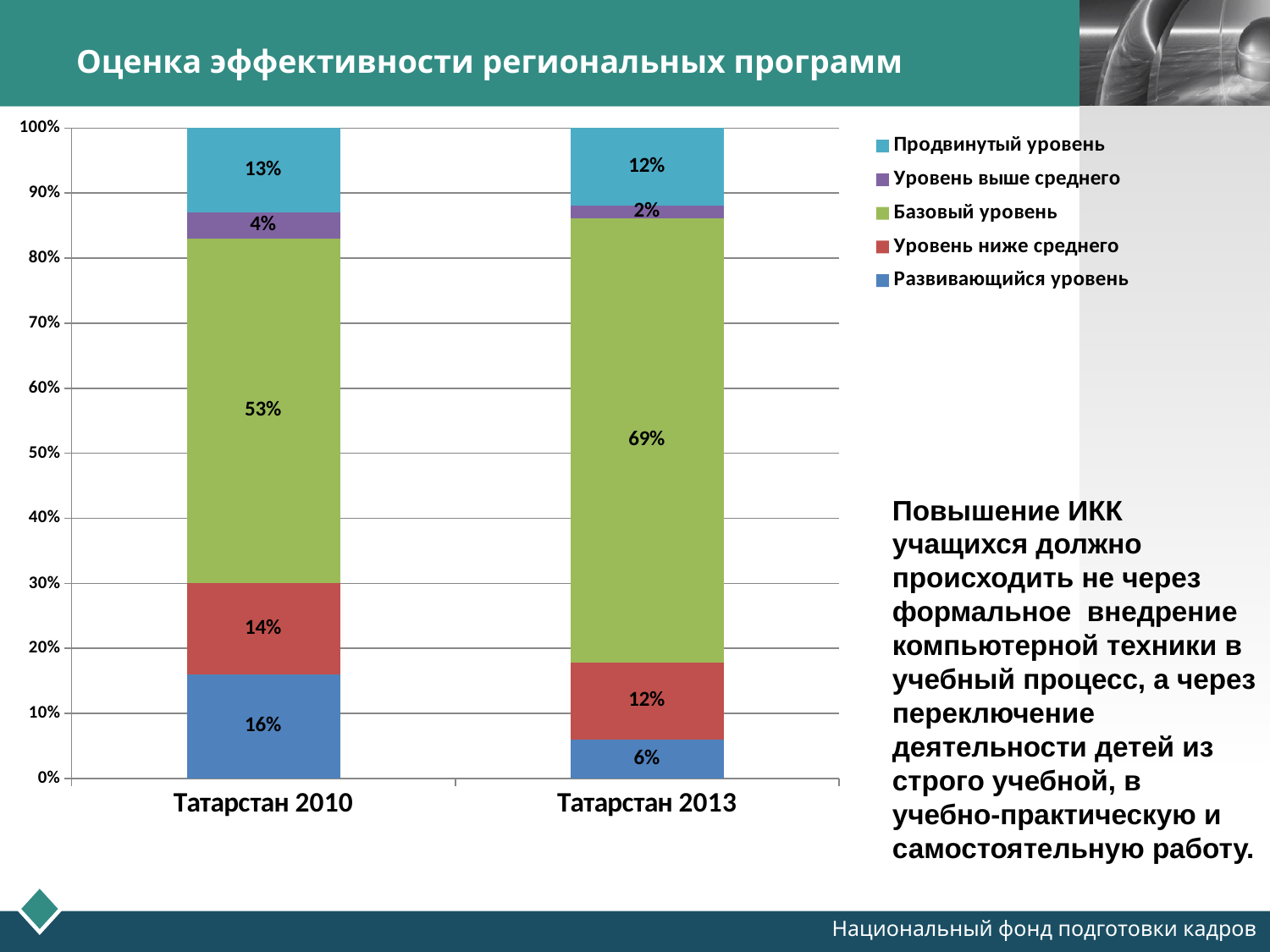
What is the value for Развивающийся уровень in Татарстан 2013? 6% Which is larger: Развивающийся уровень in Татарстан 2010 or in Татарстан 2013? Татарстан 2010 Which series has the largest share in Татарстан 2013? Базовый уровень Which series has the smallest share in Татарстан 2010? Уровень выше среднего What is the value for Продвинутый уровень in Татарстан 2013? 12% What is the value for Базовый уровень in Татарстан 2010? 53% What is the value for Уровень выше среднего in Татарстан 2010? 4% How many categories are shown on the x axis of the chart? 2 What is the difference between the Базовый уровень values for Татарстан 2013 and Татарстан 2010? 16% What kind of chart is shown on the slide? Stacked bar chart How many series does the chart legend list? 5 What is the value for Базовый уровень in Татарстан 2013? 69%